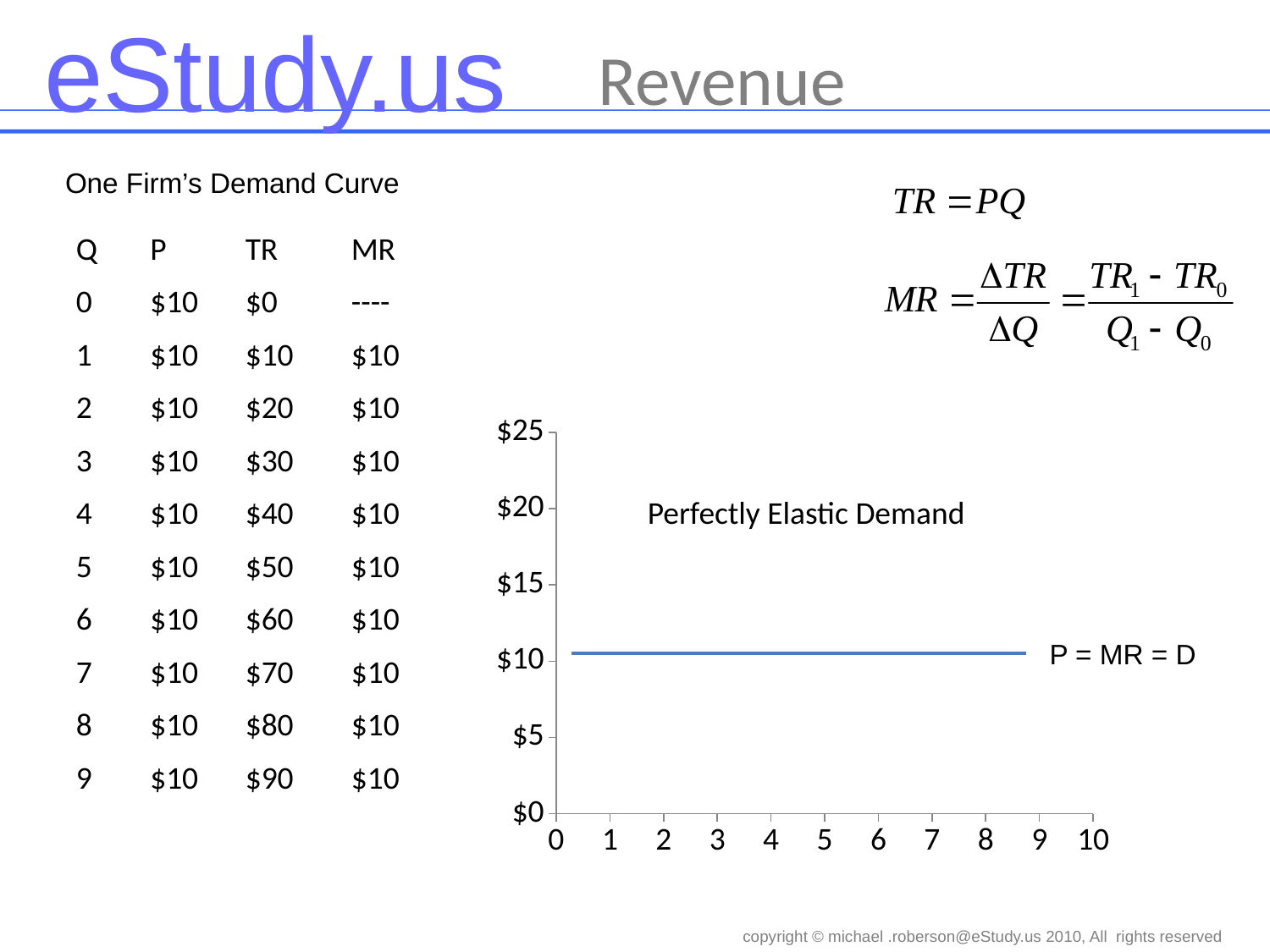
Is the value of the plotted line greater or less than $5? greater Does the plotted line rise, fall, or stay flat as quantity increases along the x axis? stays flat Is the value of the plotted line greater or less than $15? less How many tick labels are shown on the chart's x axis? 11 What text label is placed inside the chart above the plotted line? Perfectly Elastic Demand What is the highest value labelled on the chart's y axis? $25 What kind of chart is shown on the slide? line chart What is the value of the plotted line at a quantity of 2? $10 What is the value of the plotted line at a quantity of 5? $10